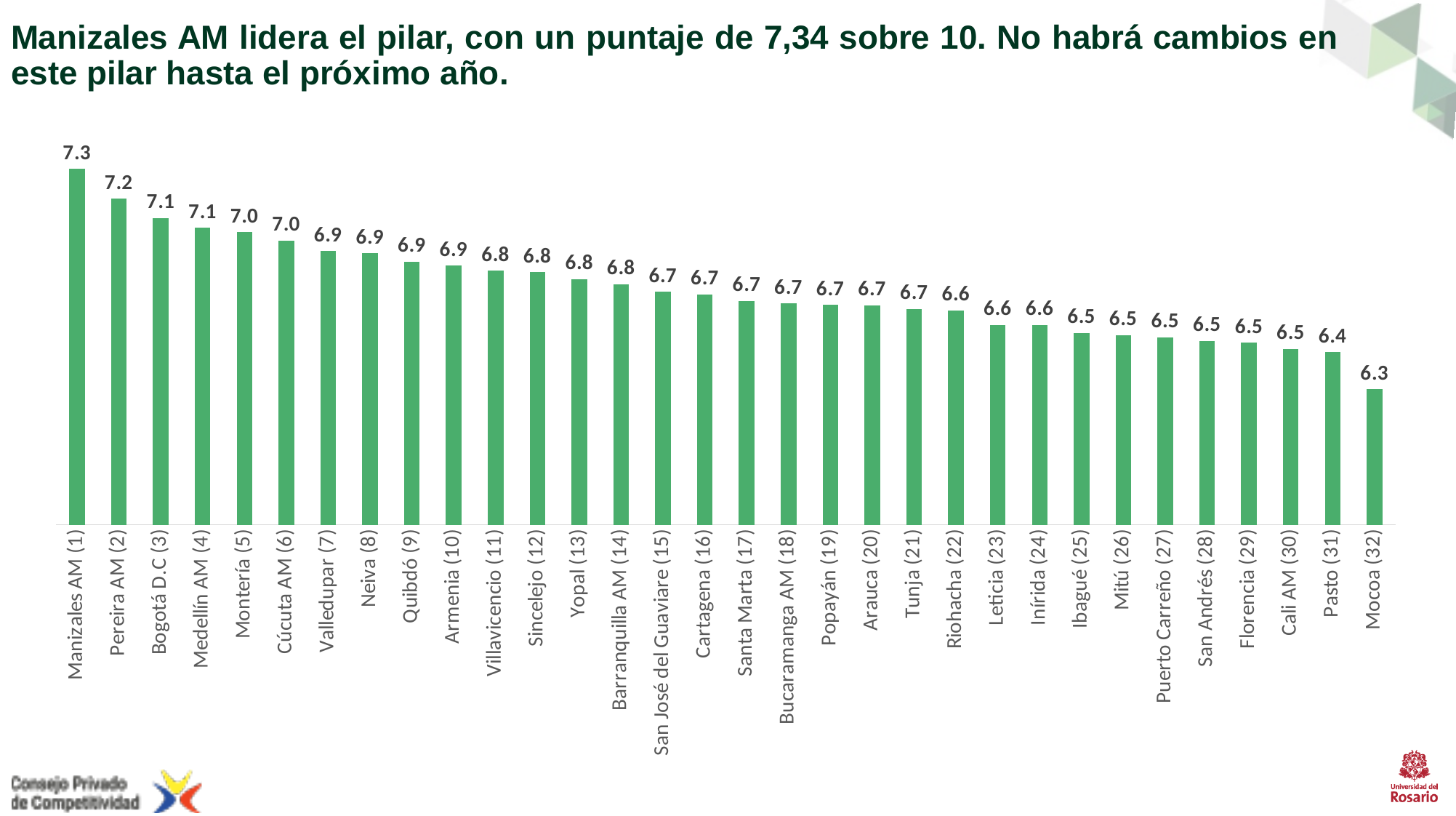
How many cities are shown in the chart? 32 What is the value shown for Manizales AM (1)? 7.3 What is the difference between the values for Pereira AM (2) and Pasto (31)? 0.8 Which city has the highest value in the chart? Manizales AM (1) What is the value shown for Bucaramanga AM (18)? 6.7 What kind of chart is shown on the slide? Bar chart Which city has the lowest value in the chart? Mocoa (32) Which has a larger value, Bogotá D.C (3) or Tunja (21)? Bogotá D.C (3) What is the difference between the values for Manizales AM (1) and Mocoa (32)? 1.0 What is the value shown for Pasto (31)? 6.4 Do the values rise or fall from left to right along the x axis? Fall What is the value shown for Mocoa (32)? 6.3